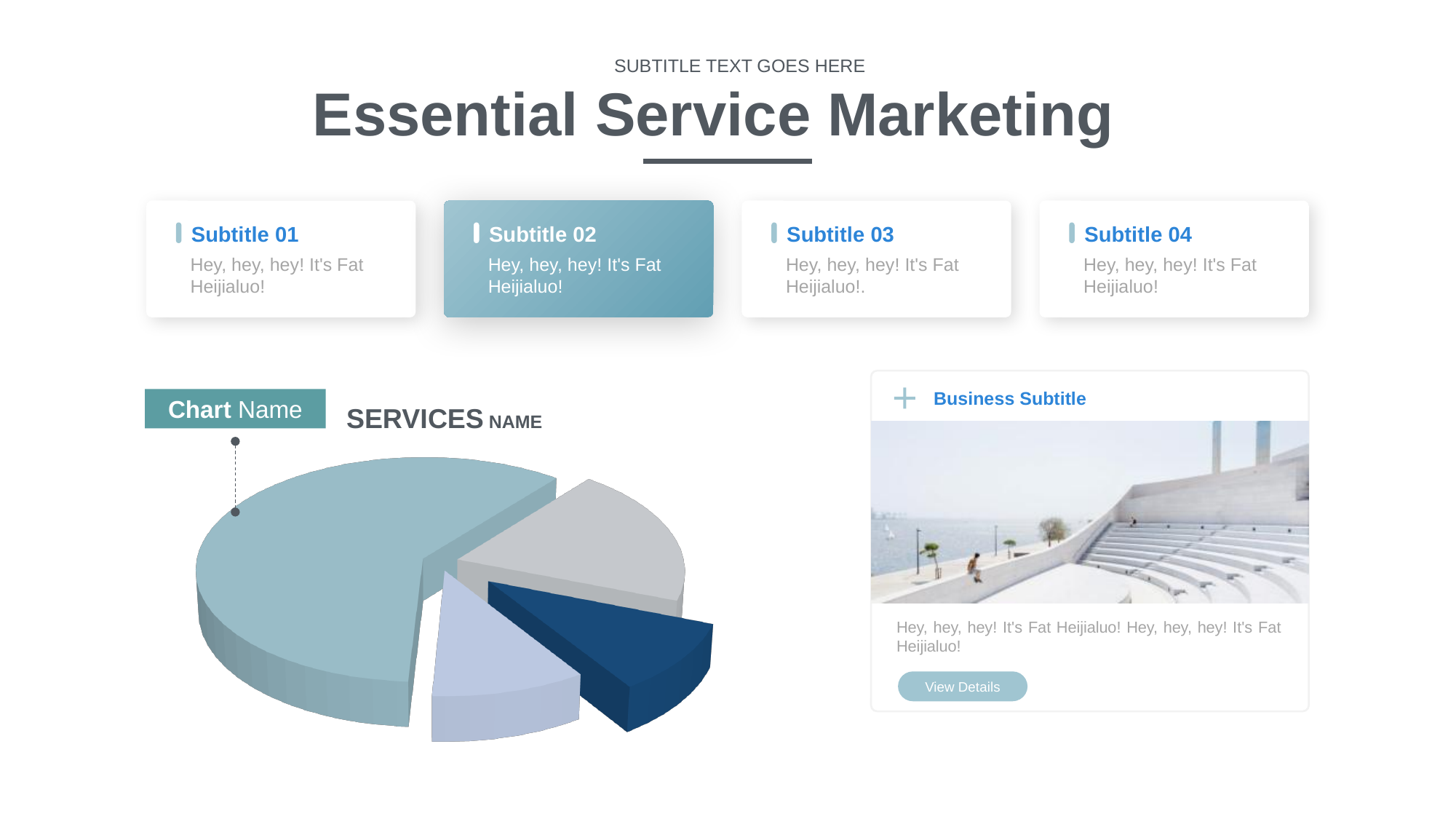
How many slices does the pie chart have? 4 Which is larger in the pie chart, the grey slice or the dark blue slice? the grey slice Which slice of the pie chart is the largest? the light teal slice What colour is the largest slice of the pie chart? light teal What text label appears above the pie chart? SERVICES NAME What kind of chart is shown on the slide? pie chart Does the largest slice of the pie chart take up more or less than half of the pie? more Which is larger in the pie chart, the light teal slice or the grey slice? the light teal slice